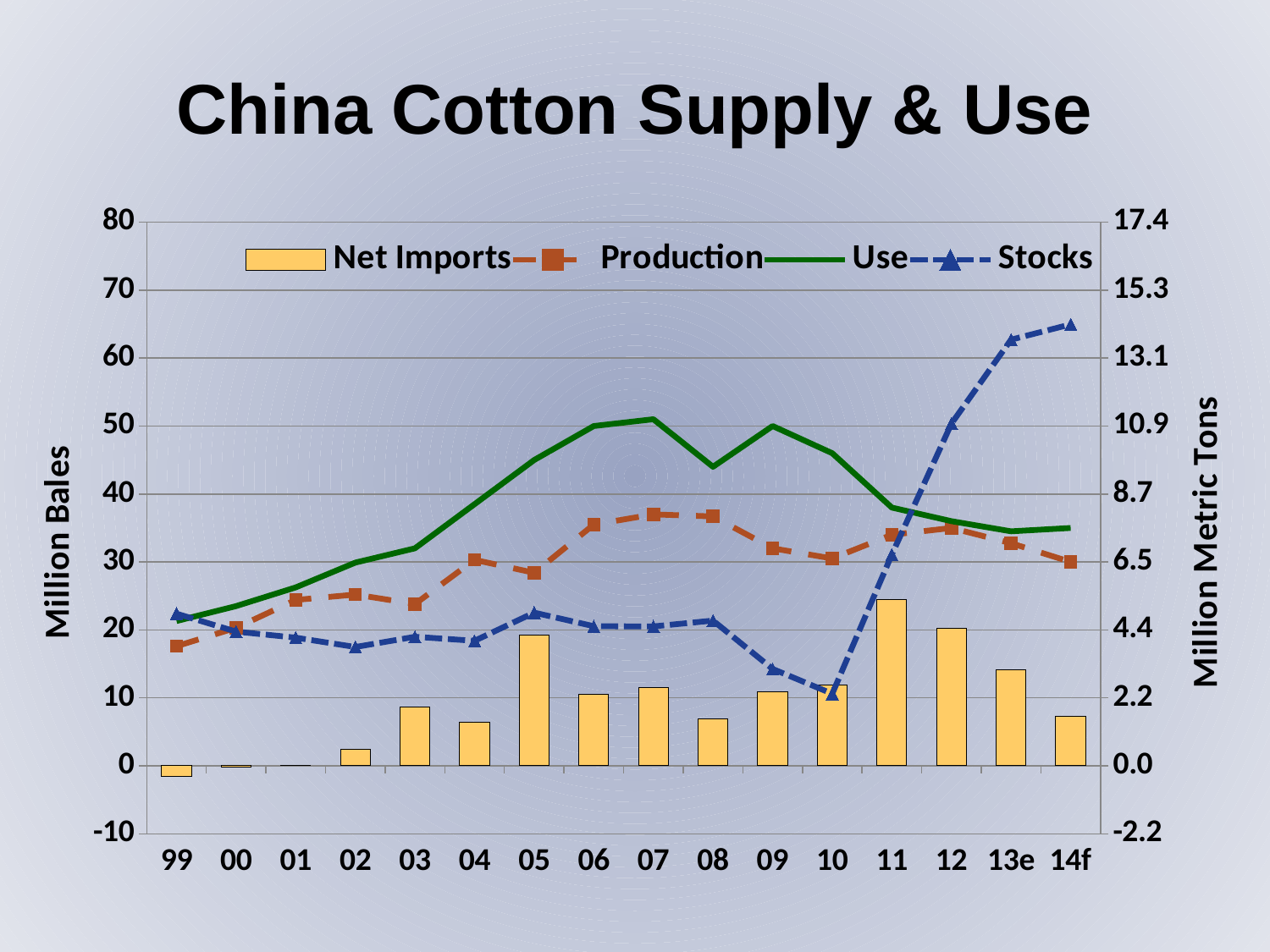
In which year is the Stocks line at its lowest point? 10 In which year is the Use line at its lowest? 99 In which year is the Net Imports bar the tallest? 11 What kind of chart is shown on the slide? A combination bar and line chart In which year does the Stocks line reach its highest point? 14f How many years are shown along the x axis? 16 Is the Use value for 99 greater or less than 30 million bales? less How many series does the legend list? 4 Which is larger in 06, Use or Production? Use What is the label on the left vertical axis? Million Bales Does the Stocks line rise or fall from 10 to 14f? rise Is the Net Imports value for 11 greater or less than 20 million bales? greater